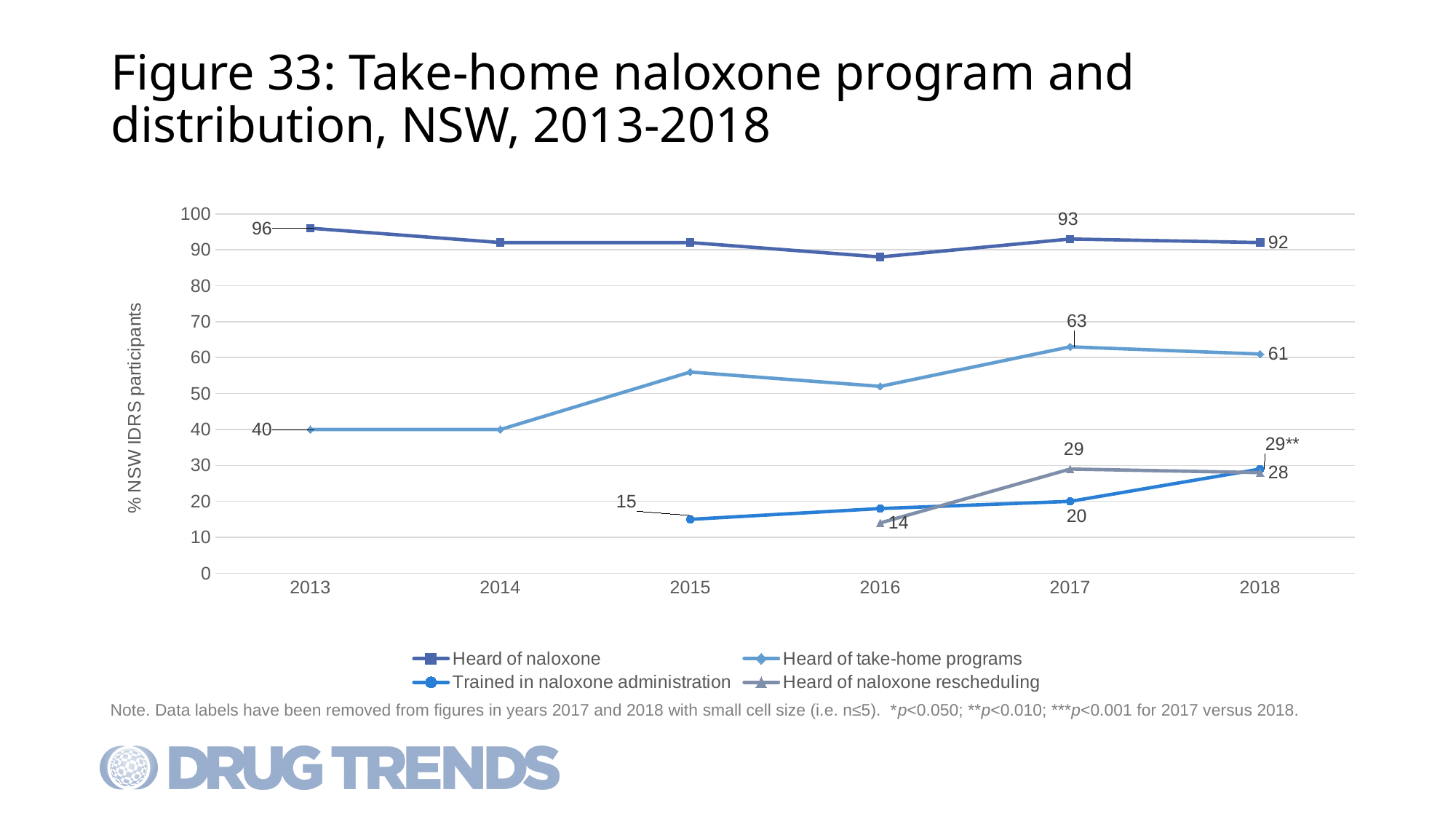
Is the value for Heard of naloxone in 2016 greater or less than 90? less What kind of chart is shown on the slide? line chart What is the value for Heard of naloxone in 2013? 96 What is the difference between the Heard of naloxone values in 2017 and 2018? 1 What is the value for Heard of naloxone rescheduling in 2016? 14 What is the value for Heard of take-home programs in 2017? 63 What is the value for Trained in naloxone administration in 2015? 15 What is the difference between the Heard of take-home programs values in 2018 and 2013? 21 Which series has the highest value in 2018? Heard of naloxone How many series does the legend list? 4 Is the value for Heard of take-home programs in 2015 greater or less than 50? greater In 2018, which is larger: Heard of take-home programs or Heard of naloxone rescheduling? Heard of take-home programs